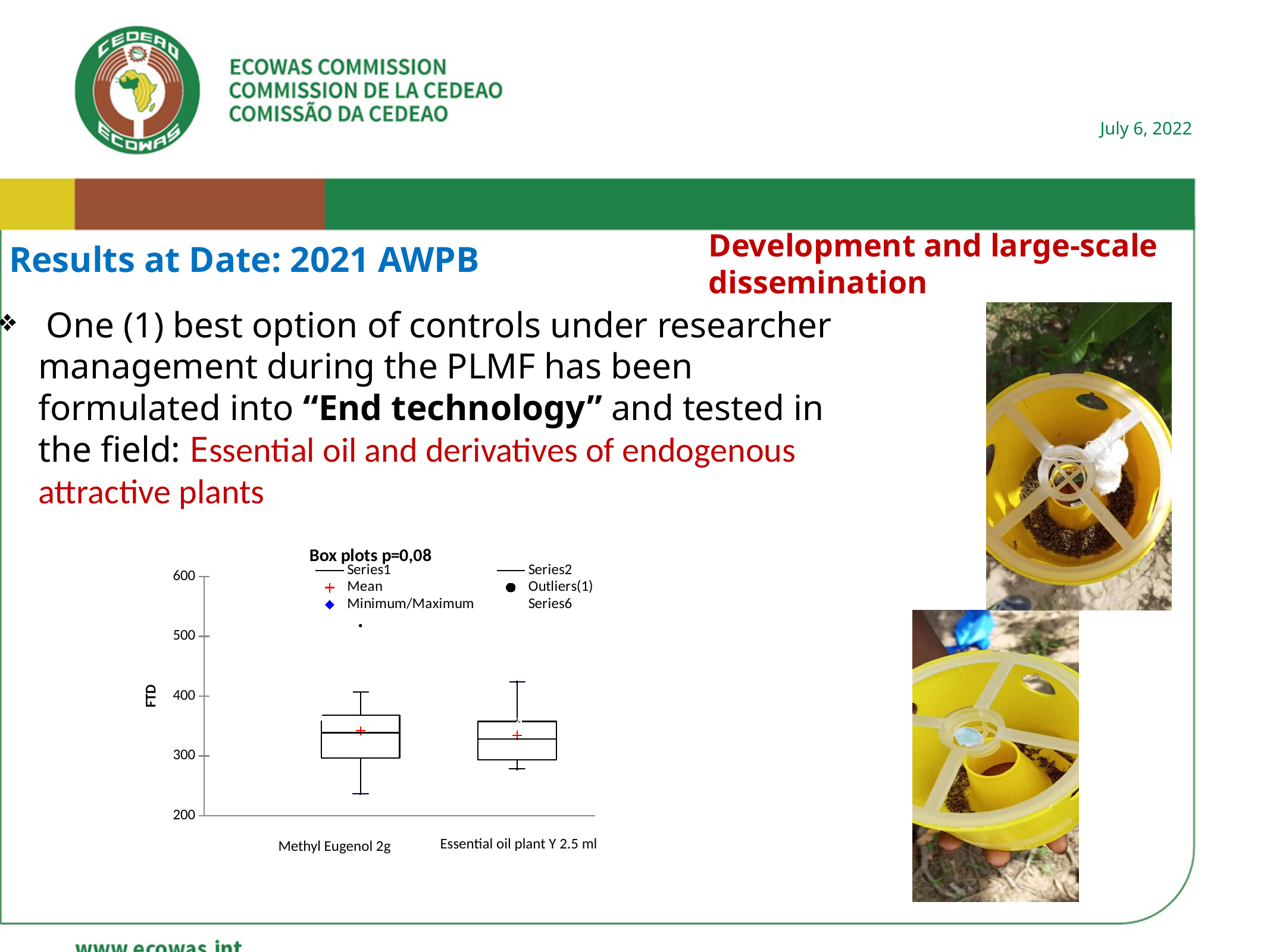
Which category has an outlier point plotted in the box plot chart? Methyl Eugenol 2g What kind of chart is shown on the slide? box plot Is the median value for Essential oil plant Y 2.5 ml greater or less than 300? greater Is the minimum whisker value for Methyl Eugenol 2g greater or less than 300? less What is the title of the box plot chart? Box plots p=0,08 Is the outlier point for Methyl Eugenol 2g greater or less than 500? greater What is the label on the y axis of the box plot chart? FTD How many categories are shown on the x axis of the box plot chart? 2 Which category has the lower minimum whisker value, Methyl Eugenol 2g or Essential oil plant Y 2.5 ml? Methyl Eugenol 2g How many entries does the legend of the box plot chart list? 6